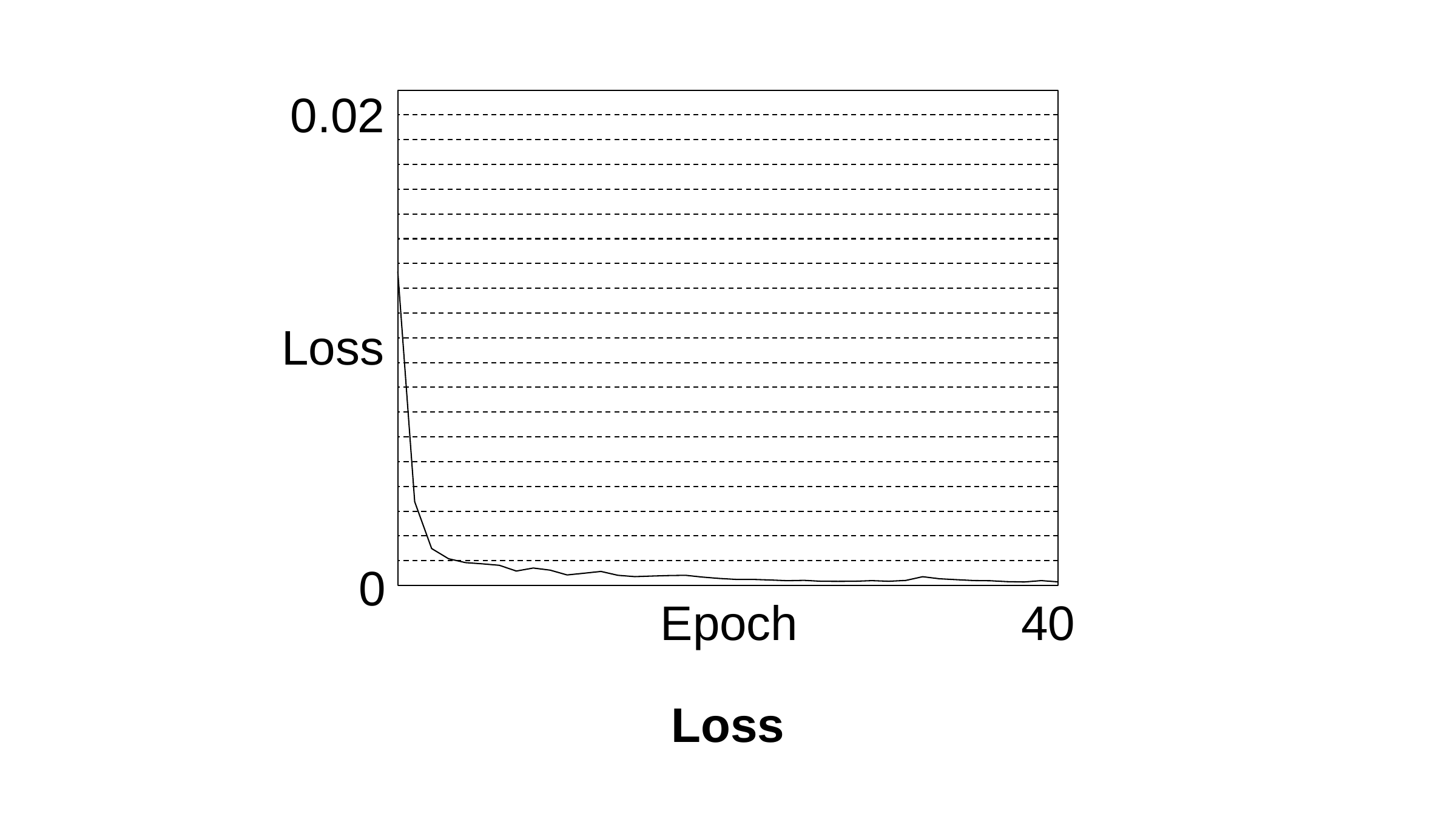
Is the loss value at the first epoch greater or less than 0.02? less Where along the x axis is the loss highest: at the beginning or at the end? at the beginning What is the label of the x axis? Epoch What kind of chart is shown on the slide? line chart What is the highest value labelled on the y axis? 0.02 What is the title of the chart? Loss Is the loss value at epoch 40 greater or less than 0.02? less Does the loss rise or fall as the epoch increases along the x axis? fall Is the loss at the start of training greater or less than the loss at epoch 40? greater What is the highest epoch value labelled on the x axis? 40